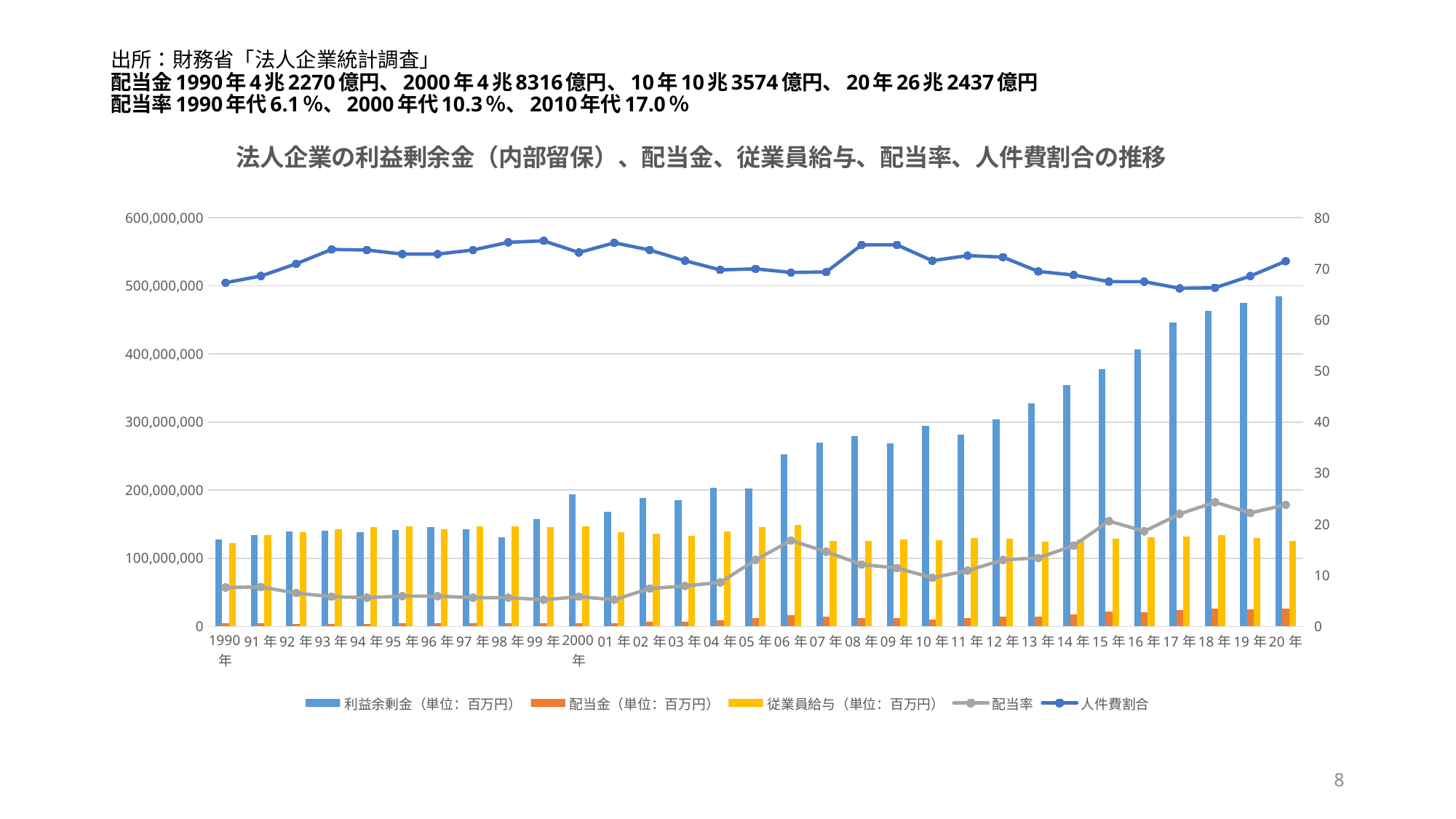
What kind of chart is shown on the slide? A combined bar and line chart In 20年, which is larger: 利益余剰金 or 従業員給与? 利益余剰金 Does the 利益余剰金 series generally rise or fall from 1990年 to 20年? rise How many years (categories) are plotted along the x axis? 31 Is the 配当率 value for 20年 greater or less than 20 on the right axis? greater How many series does the legend list? 5 In which year is the 利益余剰金 bar the highest? 20年 Is the 人件費割合 value for 1990年 greater or less than 60 on the right axis? greater What is the title of the chart? 法人企業の利益剰余金（内部留保）、配当金、従業員給与、配当率、人件費割合の推移 Is the 利益余剰金 value for 10年 greater or less than 200,000,000? greater In which year does the 配当率 line reach its highest point? 18年